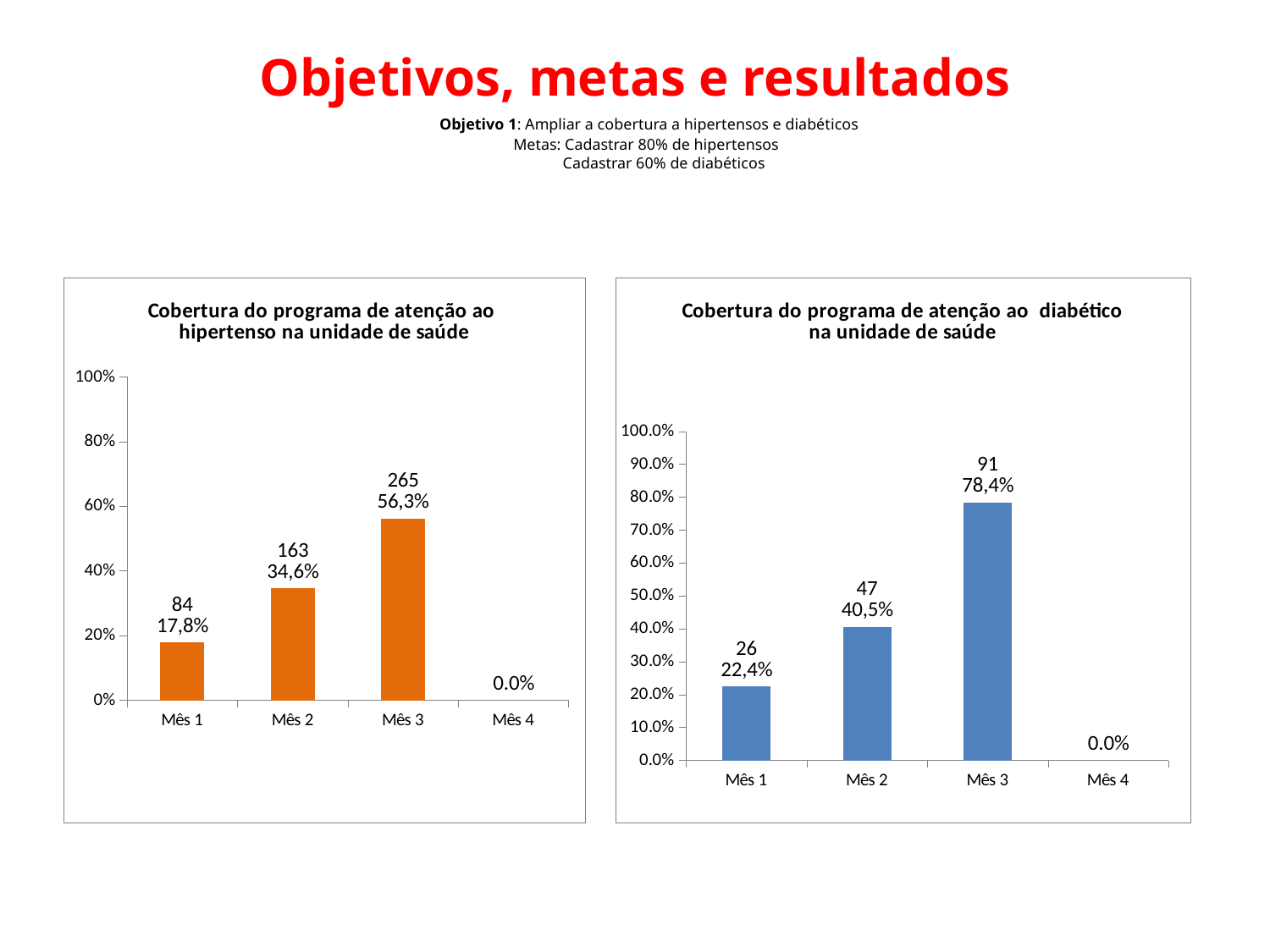
How many months (categories) are shown on the x axis of the right chart (diabético)? 4 In the right chart (diabético), what count is printed above the bar for Mês 3? 91 In the right chart (Cobertura do programa de atenção ao diabético), what percentage is shown for Mês 1? 22,4% In the right chart (diabético), which month has the lowest coverage? Mês 4 In the left chart (hipertenso), which month has the highest coverage? Mês 3 In the right chart (diabético), what is the difference in percentage points between Mês 3 and Mês 2? 37,9 In the left chart (Cobertura do programa de atenção ao hipertenso), what percentage is shown for Mês 3? 56,3% In the left chart (hipertenso), is the value for Mês 3 greater or less than 60%? less What type of chart is the left chart (hipertenso)? Bar chart Which is larger: the Mês 2 percentage in the left chart (hipertenso) or the Mês 2 percentage in the right chart (diabético)? Right chart (diabético), 40,5% In the right chart (diabético), do the values rise or fall from Mês 1 to Mês 3? Rise In the left chart (hipertenso), what count is printed above the bar for Mês 2? 163